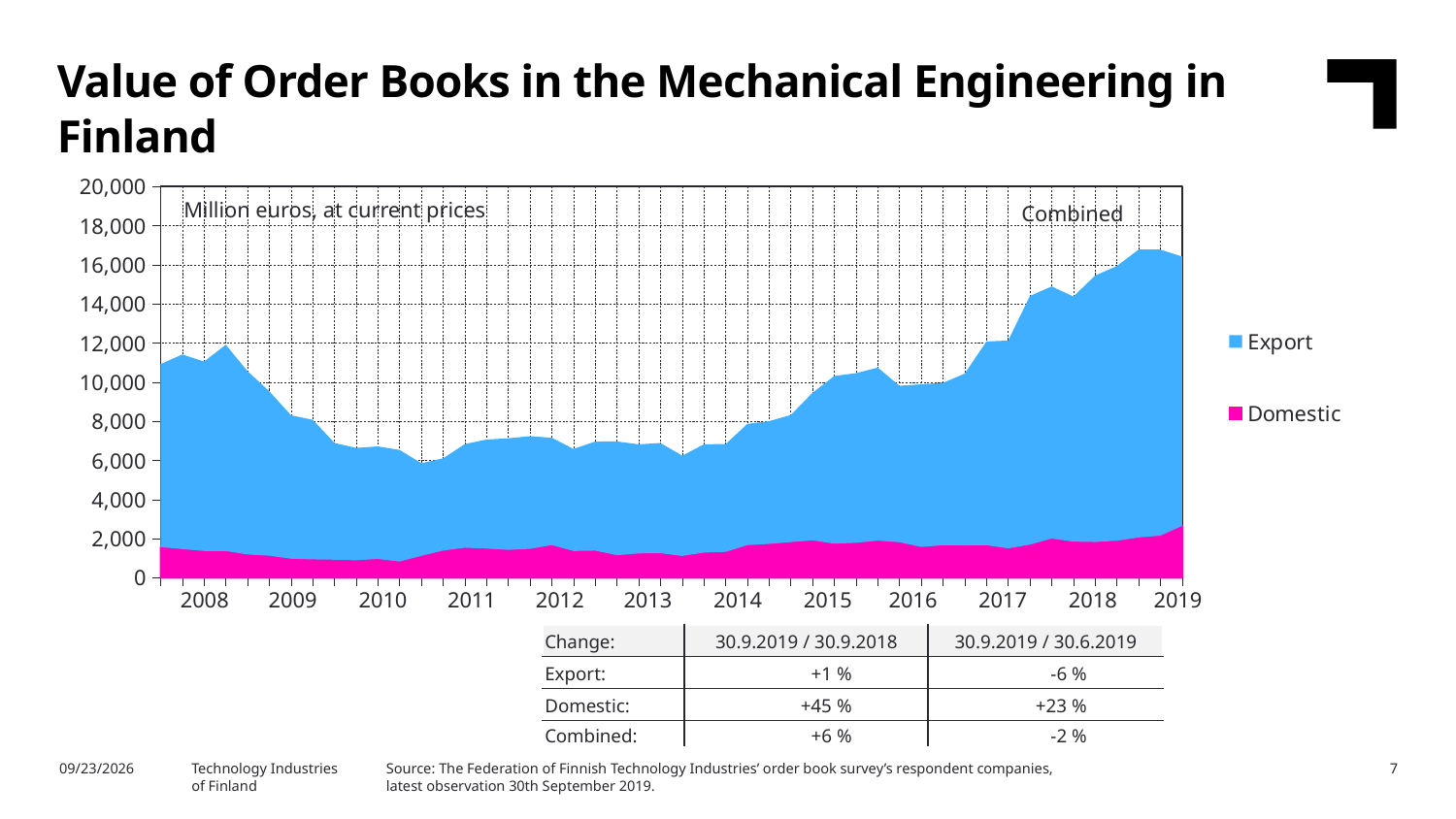
What are the two series named in the chart legend? Export and Domestic Does the combined value of order books rise or fall between 2008 and 2010? fall Does the combined value of order books rise or fall between 2016 and 2019? rise What kind of chart is shown on the slide? Stacked area chart Is the Domestic value at the end of 2019 greater or less than 2,000? greater What unit is stated in the label inside the chart area? Million euros, at current prices Is the combined value of order books at the end of 2019 greater or less than 14,000? greater Which series is larger throughout the chart, Export or Domestic? Export How many series does the chart legend list? 2 Is the combined value of order books larger at the end of 2019 or at the start of 2008? End of 2019 Is the combined value of order books at the start of 2008 greater or less than 10,000? greater